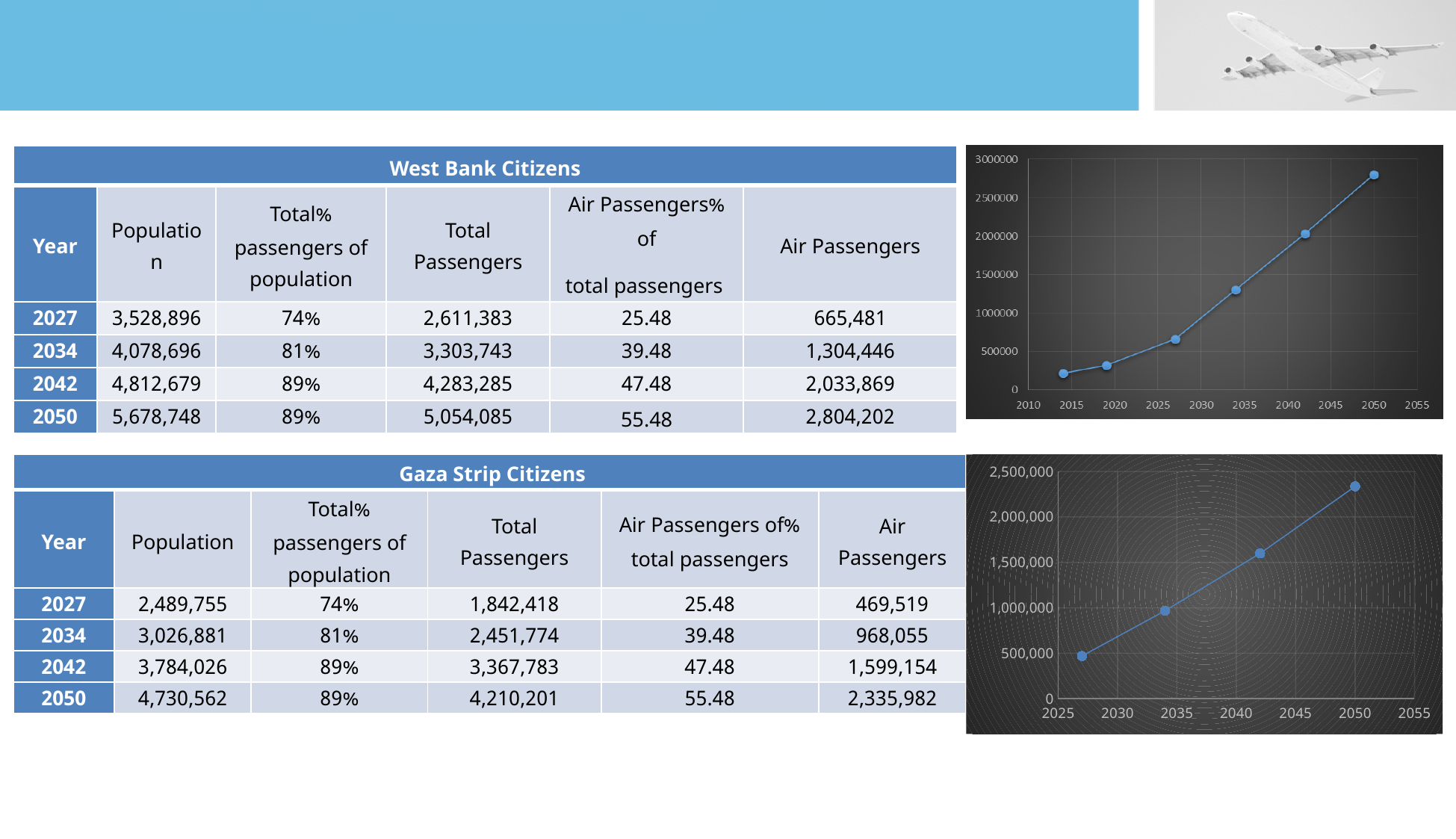
On the bottom-right chart, is the value for 2027 greater or less than 1,000,000? less How many data points are plotted on the bottom-right chart? 4 On the top-right chart, do the values rise or fall as the year increases? rise On the bottom-right chart, which has the larger value, 2034 or 2042? 2042 On the bottom-right chart, which year has the lowest value? 2027 On the bottom-right chart, which year has the highest value? 2050 On the top-right chart, is the value for 2034 greater or less than 1500000? less On the top-right chart, is the value for 2050 greater or less than 2500000? greater On the bottom-right chart, do the values rise or fall as the year increases? rise How many data points are plotted on the top-right chart? 6 What kind of chart is the top-right chart on the slide? line chart